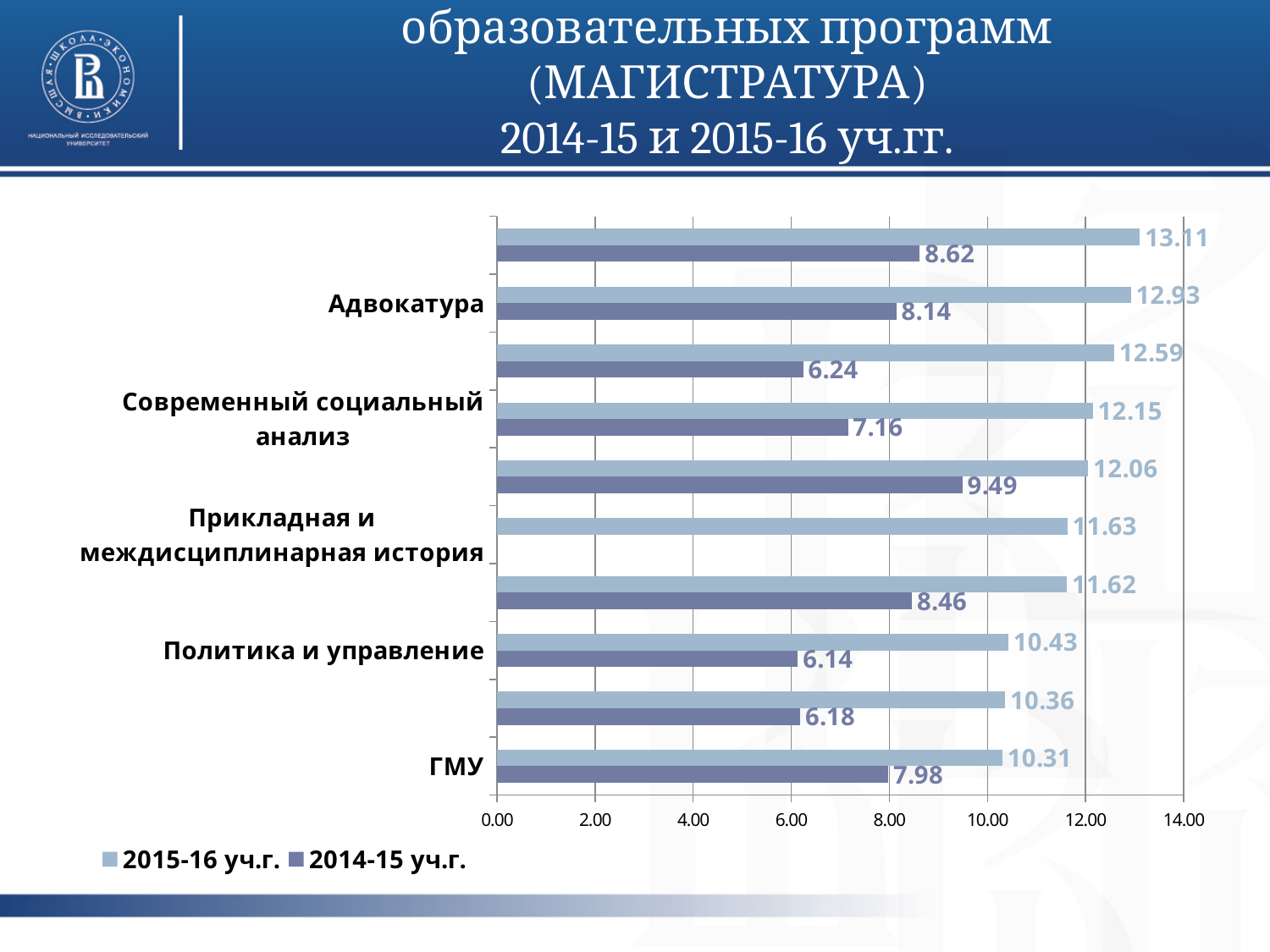
What is the value for Адвокатура in the 2014-15 уч.г. series? 8.14 What is the value for Современный социальный анализ in the 2014-15 уч.г. series? 7.16 What is the difference between the 2015-16 уч.г. and 2014-15 уч.г. values for Адвокатура? 4.79 How many series does the legend list? 2 What is the value for ГМУ in the 2014-15 уч.г. series? 7.98 What is the value for Политика и управление in the 2015-16 уч.г. series? 10.43 What is the value for Прикладная и междисциплинарная история in the 2015-16 уч.г. series? 11.63 What kind of chart is shown on the slide? bar chart What is the value for Адвокатура in the 2015-16 уч.г. series? 12.93 Which has the larger 2015-16 уч.г. value, Адвокатура or ГМУ? Адвокатура What is the difference between the 2015-16 уч.г. and 2014-15 уч.г. values for ГМУ? 2.33 Is the 2014-15 уч.г. value for Политика и управление greater or less than 8.00? less